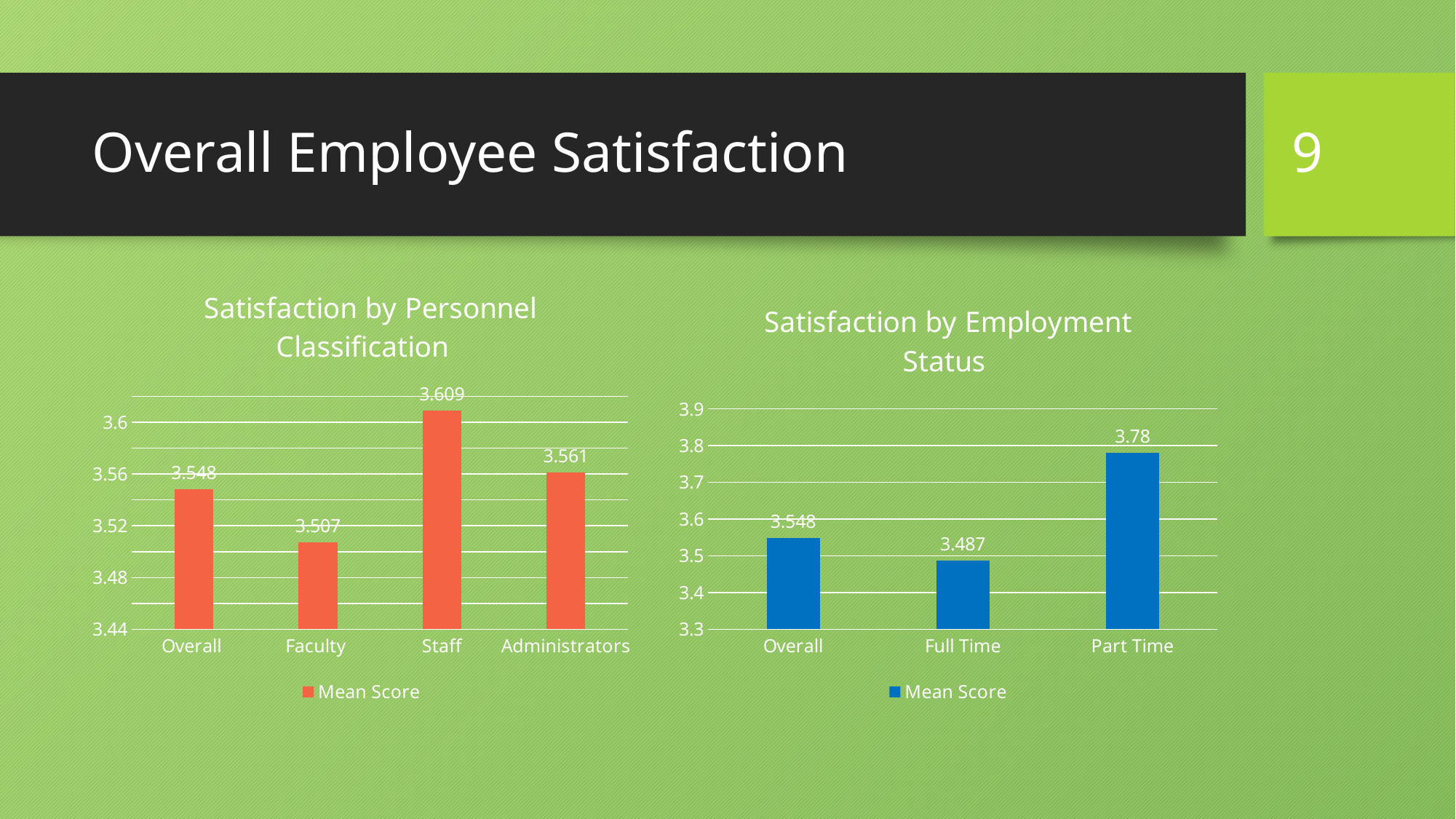
In the 'Satisfaction by Employment Status' chart, is the mean score for Overall larger than the mean score for Full Time? Yes In the 'Satisfaction by Employment Status' chart, what is the difference between the Part Time and Full Time mean scores? 0.293 In the 'Satisfaction by Personnel Classification' chart, what is the mean score for Staff? 3.609 In the 'Satisfaction by Employment Status' chart, what is the mean score for Part Time? 3.78 In the 'Satisfaction by Personnel Classification' chart, what is the difference between the Staff and Faculty mean scores? 0.102 In the 'Satisfaction by Personnel Classification' chart, which category has the lowest mean score? Faculty In the 'Satisfaction by Employment Status' chart, which category has the highest mean score? Part Time What type of chart is the 'Satisfaction by Employment Status' chart? Bar chart In the 'Satisfaction by Personnel Classification' chart, what is the mean score for Faculty? 3.507 In the 'Satisfaction by Employment Status' chart, what is the mean score for Full Time? 3.487 In the 'Satisfaction by Personnel Classification' chart, which category has the highest mean score? Staff In the 'Satisfaction by Personnel Classification' chart, how many categories are shown? 4